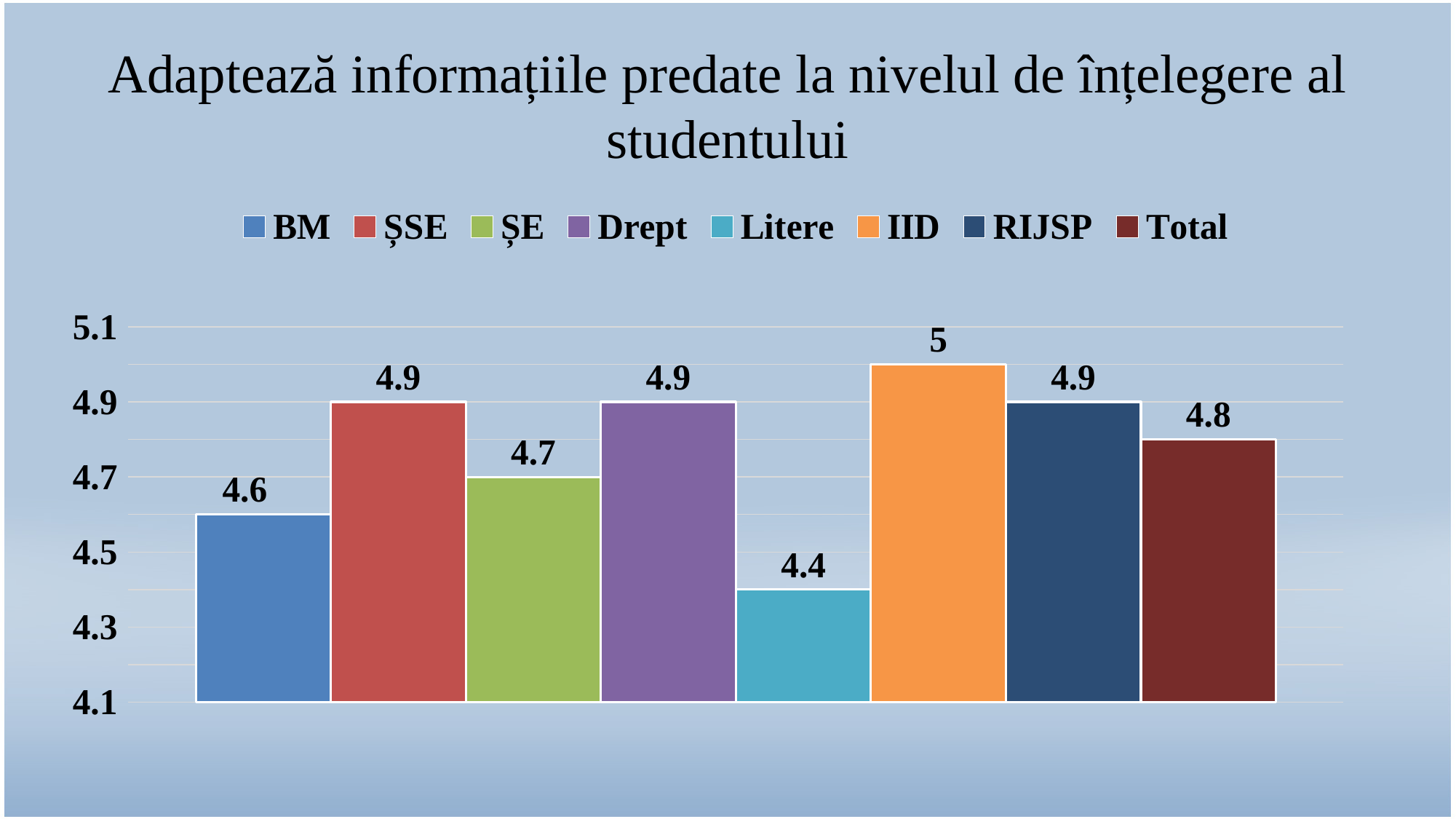
How many bars are shown in the chart? 8 What is the value for Litere? 4.4 What is the difference between the values for ȘSE and ȘE? 0.2 Which is larger, the value for BM or the value for ȘE? ȘE What kind of chart is shown on the slide? bar chart Which category has the highest value? IID How many entries does the legend list? 8 What is the value for IID? 5 Which category has the lowest value? Litere What is the difference between the values for IID and Litere? 0.6 What is the value for BM? 4.6 What is the value for Total? 4.8